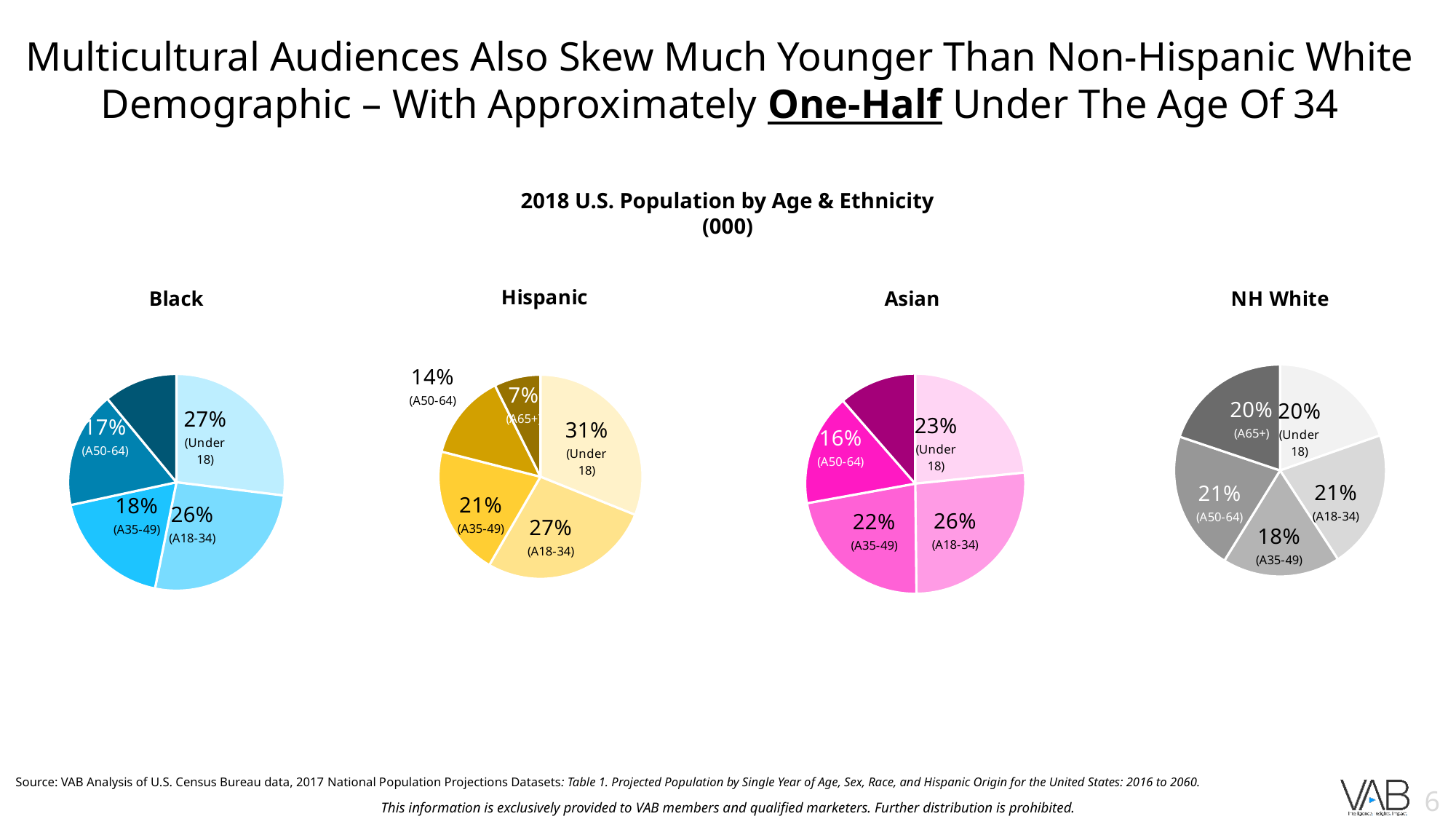
How many pie charts are shown on the slide? 4 What type of chart is used to show the 2018 U.S. Population by Age & Ethnicity? Pie chart In the Black pie chart, what percentage is shown for the A18-34 slice? 26% Which is larger: the Under 18 share in the Hispanic pie chart or the Under 18 share in the NH White pie chart? Hispanic In the NH White pie chart, what percentage is shown for the A35-49 slice? 18% In the Hispanic pie chart, what share of the population is Under 18? 31% In the Asian pie chart, what percentage is shown for the A50-64 slice? 16% In the Hispanic pie chart, which age group has the smallest share? A65+ In the Black pie chart, what is the difference in percentage points between the Under 18 slice and the A35-49 slice? 9 In the Asian pie chart, which labeled age group has the largest share? A18-34 In the Hispanic pie chart, what is the difference in percentage points between the Under 18 slice and the A50-64 slice? 17 In the Hispanic pie chart, which age group has the largest share? Under 18